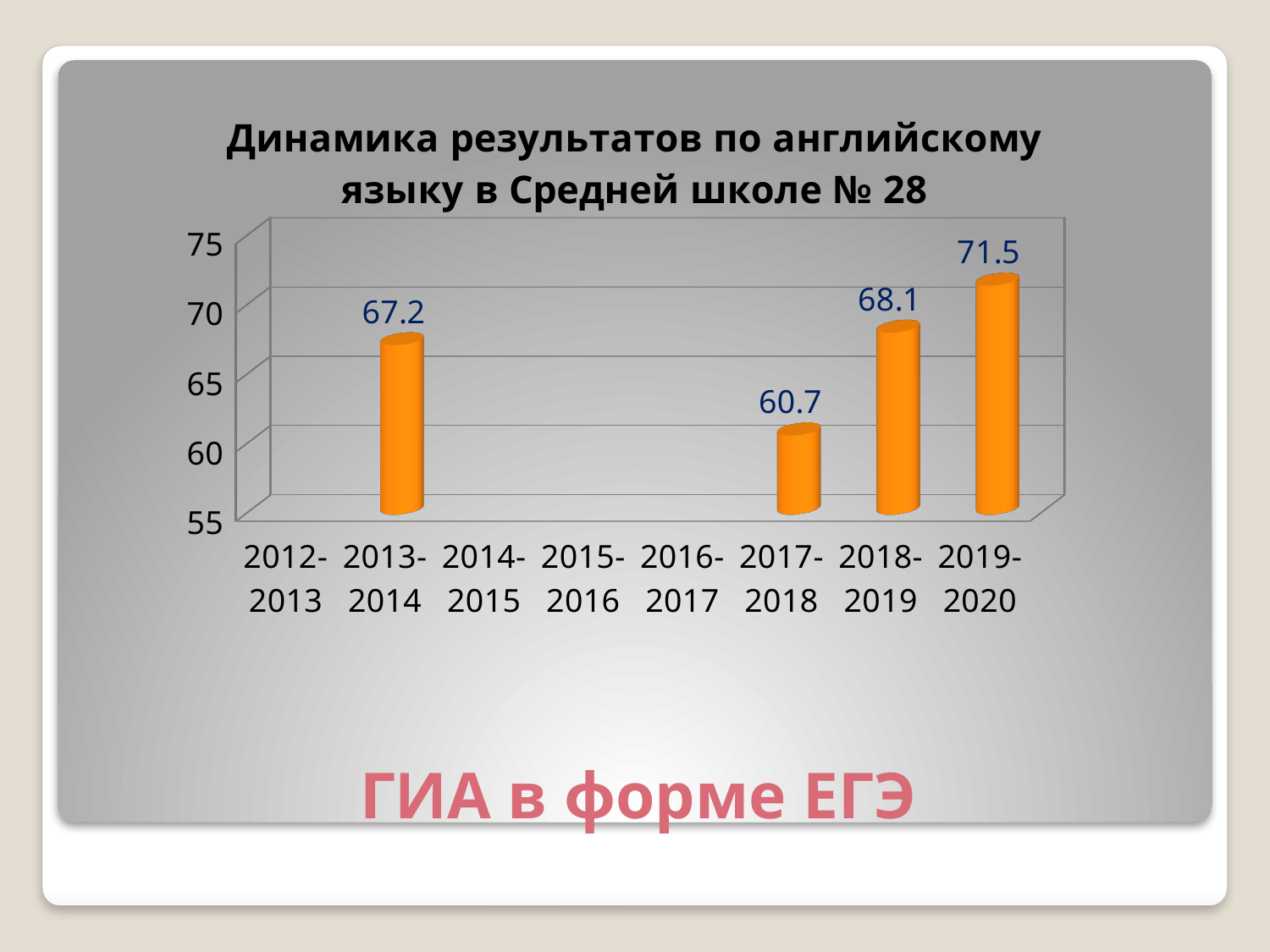
What is the value for 2019-2020? 71.5 Which school year with a plotted bar has the lowest value? 2017-2018 What kind of chart is shown on the slide? Bar chart Which is larger, the value for 2013-2014 or the value for 2017-2018? 2013-2014 How many school-year categories are shown on the x axis? 8 Do the values rise or fall from 2017-2018 to 2019-2020? Rise What is the value for 2018-2019? 68.1 What is the value for 2013-2014? 67.2 What is the difference between the values for 2018-2019 and 2013-2014? 0.9 Which school year has the highest value? 2019-2020 What is the difference between the values for 2019-2020 and 2017-2018? 10.8 What is the value for 2017-2018? 60.7